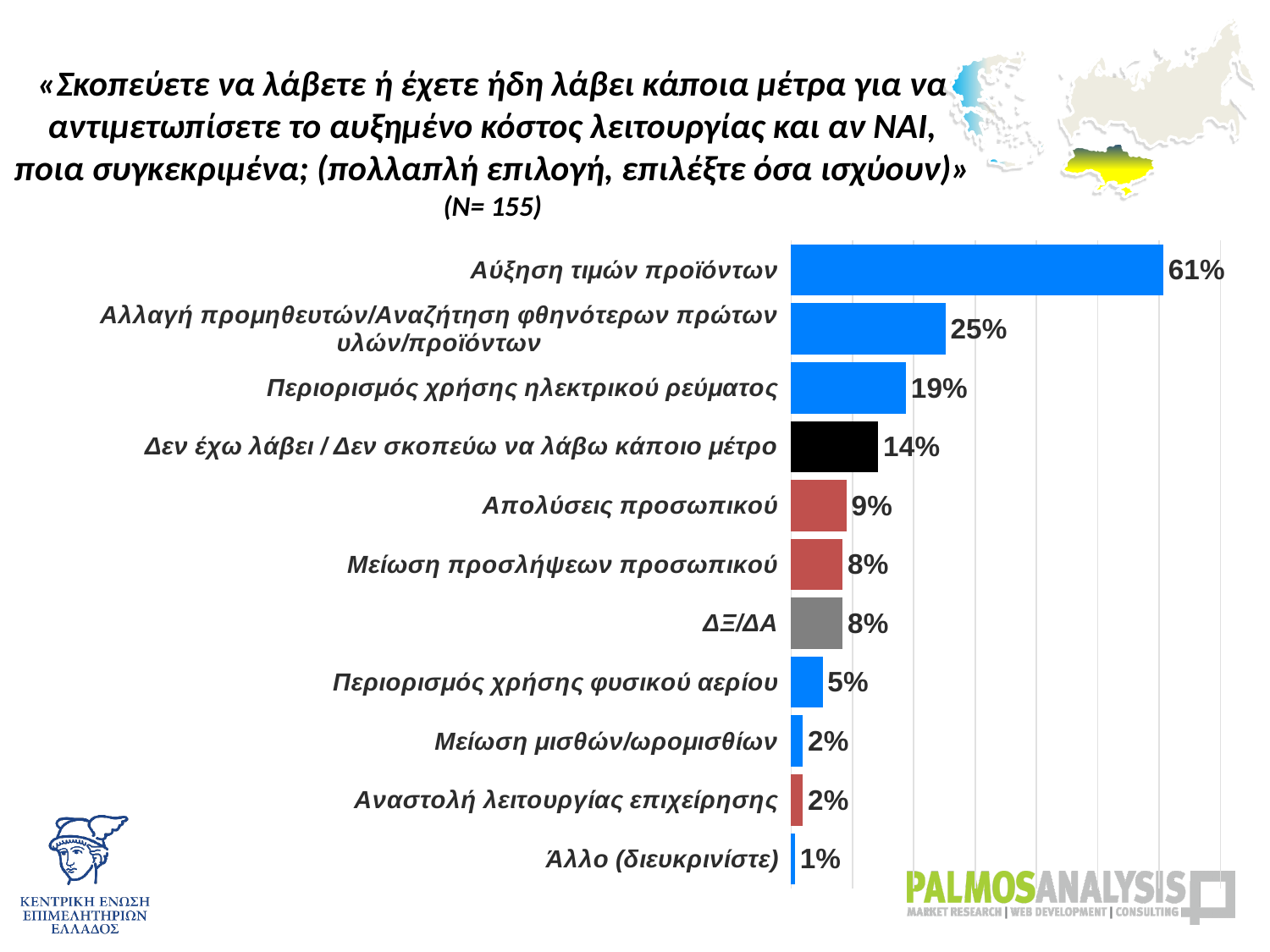
What is the value for Περιορισμός χρήσης ηλεκτρικού ρεύματος? 19% Which category has the lowest value? Άλλο (διευκρινίστε) What is the difference between Αύξηση τιμών προϊόντων and Αλλαγή προμηθευτών/Αναζήτηση φθηνότερων πρώτων υλών/προϊόντων? 36% Which category has the highest value? Αύξηση τιμών προϊόντων What is the value for Δεν έχω λάβει / Δεν σκοπεύω να λάβω κάποιο μέτρο? 14% What kind of chart is shown on the slide? Bar chart How many categories are shown in the chart? 11 What is the value for Αύξηση τιμών προϊόντων? 61% What is the value for Περιορισμός χρήσης φυσικού αερίου? 5% What is the difference between Απολύσεις προσωπικού and Μείωση προσλήψεων προσωπικού? 1% What is the sample size (N) stated on the slide? 155 Which is larger, Περιορισμός χρήσης ηλεκτρικού ρεύματος or Δεν έχω λάβει / Δεν σκοπεύω να λάβω κάποιο μέτρο? Περιορισμός χρήσης ηλεκτρικού ρεύματος